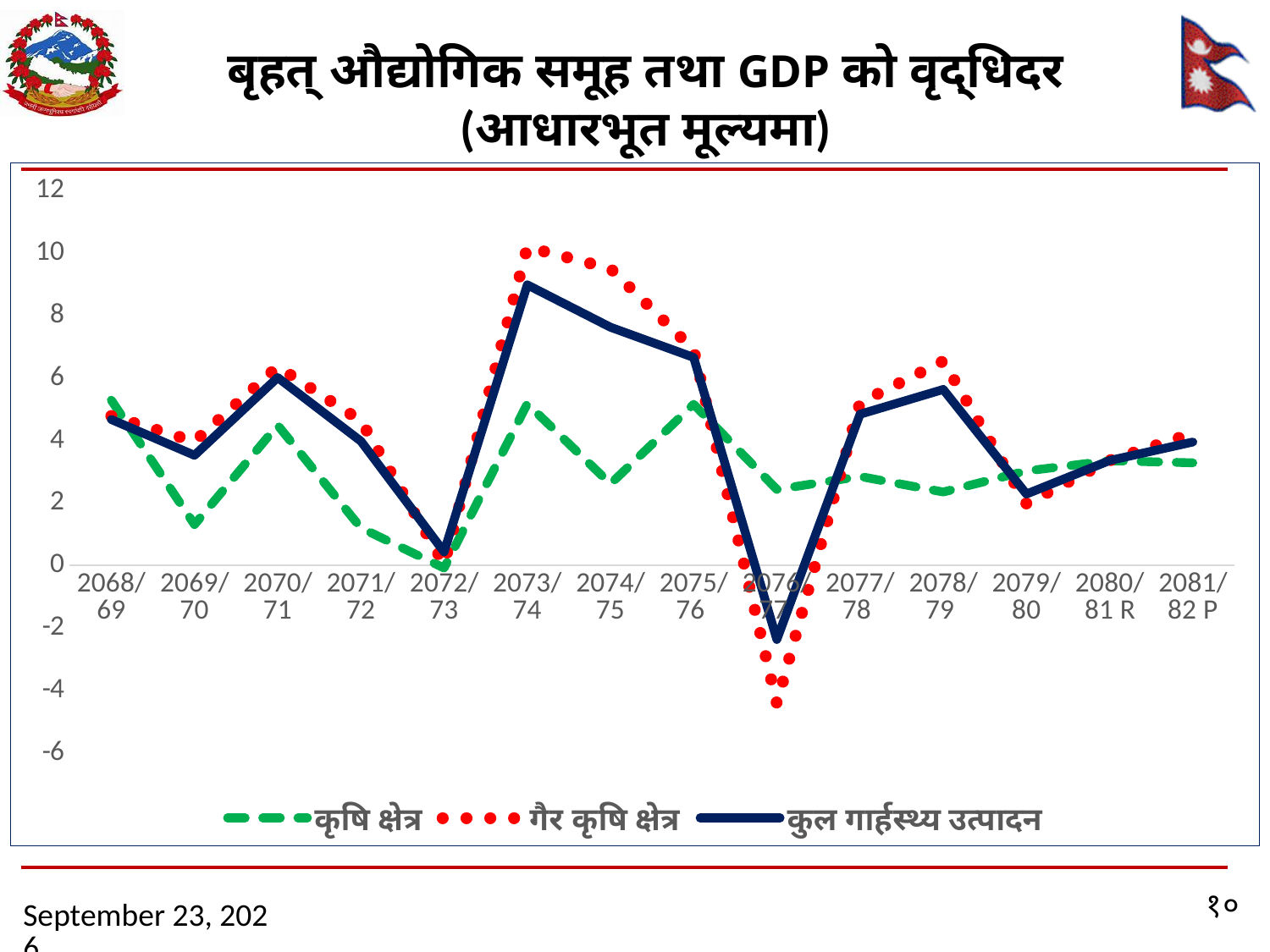
In 2076/77, which series has the larger value: कृषि क्षेत्र or कुल गार्हस्थ्य उत्पादन? कृषि क्षेत्र Which series is drawn as a red dotted line? गैर कृषि क्षेत्र In which year does the कुल गार्हस्थ्य उत्पादन series reach its lowest value? 2076/77 Does the कुल गार्हस्थ्य उत्पादन series rise or fall from 2073/74 to 2076/77? fall Is the value for कुल गार्हस्थ्य उत्पादन in 2076/77 greater or less than 0? less In which year does the गैर कृषि क्षेत्र series reach its highest value? 2073/74 How many series does the legend list? 3 Is the value for कृषि क्षेत्र in 2069/70 greater or less than 2? less What kind of chart is shown on the slide? line chart Is the value for गैर कृषि क्षेत्र in 2073/74 greater or less than 8? greater In which year does the गैर कृषि क्षेत्र series reach its lowest value? 2076/77 How many fiscal years are plotted along the x axis? 14